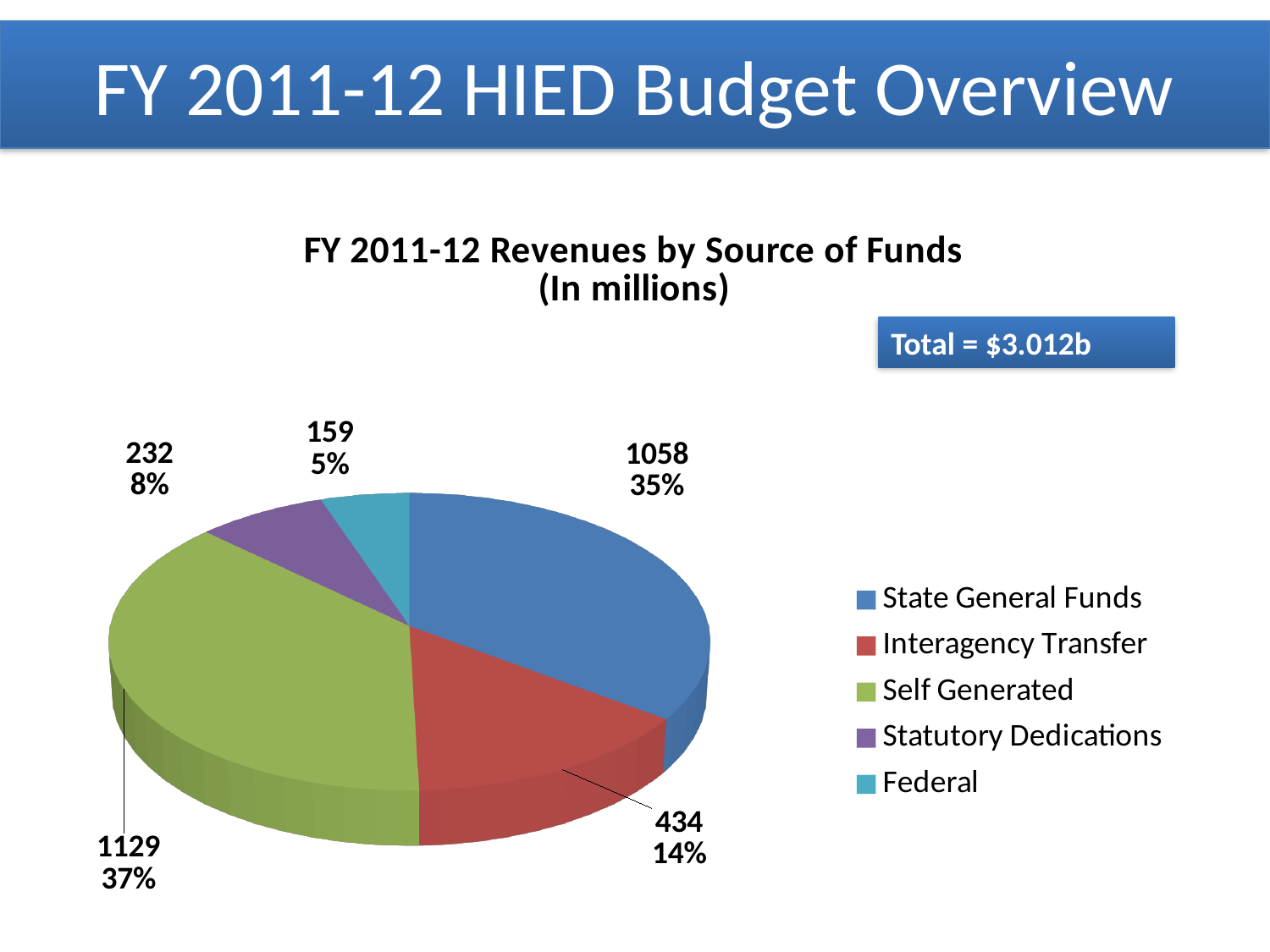
How many categories does the legend list? 5 What is the difference between the values for Self Generated and State General Funds? 71 What is the value for Interagency Transfer? 434 What is the value for Federal? 159 What share of the pie does Statutory Dedications represent? 8% Which is larger, Interagency Transfer or Statutory Dedications? Interagency Transfer Which source of funds has the smallest value? Federal What share of the pie does Self Generated represent? 37% What is the value for Self Generated? 1129 What kind of chart is shown on the slide? Pie chart Which source of funds has the largest value? Self Generated What is the value for State General Funds? 1058